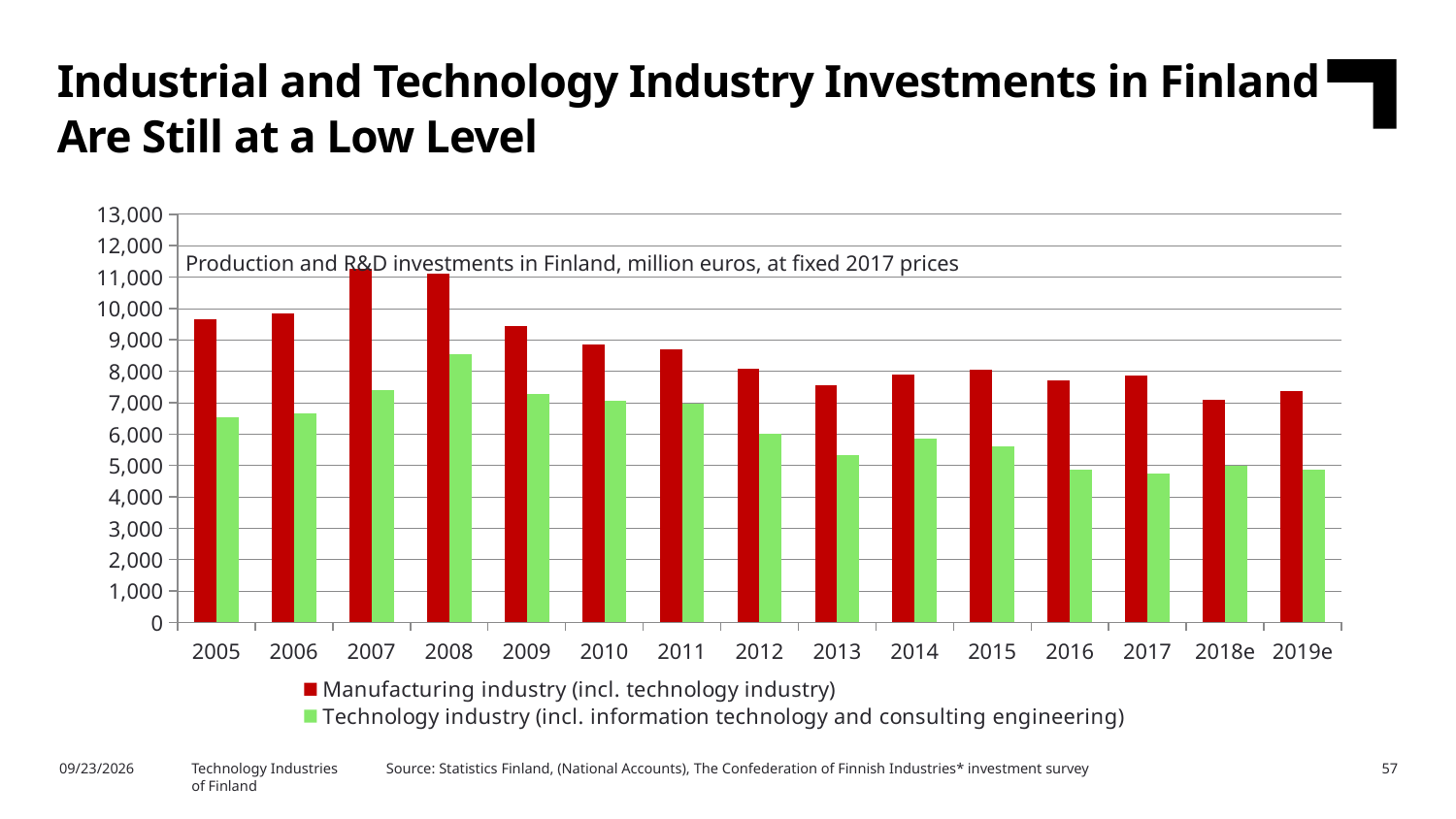
What unit does the chart's subtitle say the values are in? million euros, at fixed 2017 prices Is the Manufacturing industry value for 2007 greater or less than 11,000? greater Is the Technology industry value for 2016 greater or less than 5,000? less How many years are shown on the x axis? 15 Does the Manufacturing industry value rise or fall from 2008 to 2013? fall What kind of chart is shown on the slide? bar chart Is the Technology industry value for 2008 greater or less than 8,000? greater In which year is the Manufacturing industry value highest? 2007 How many series does the legend list? 2 In which year is the Technology industry value highest? 2008 Which is larger, the Manufacturing industry value for 2010 or for 2015? 2010